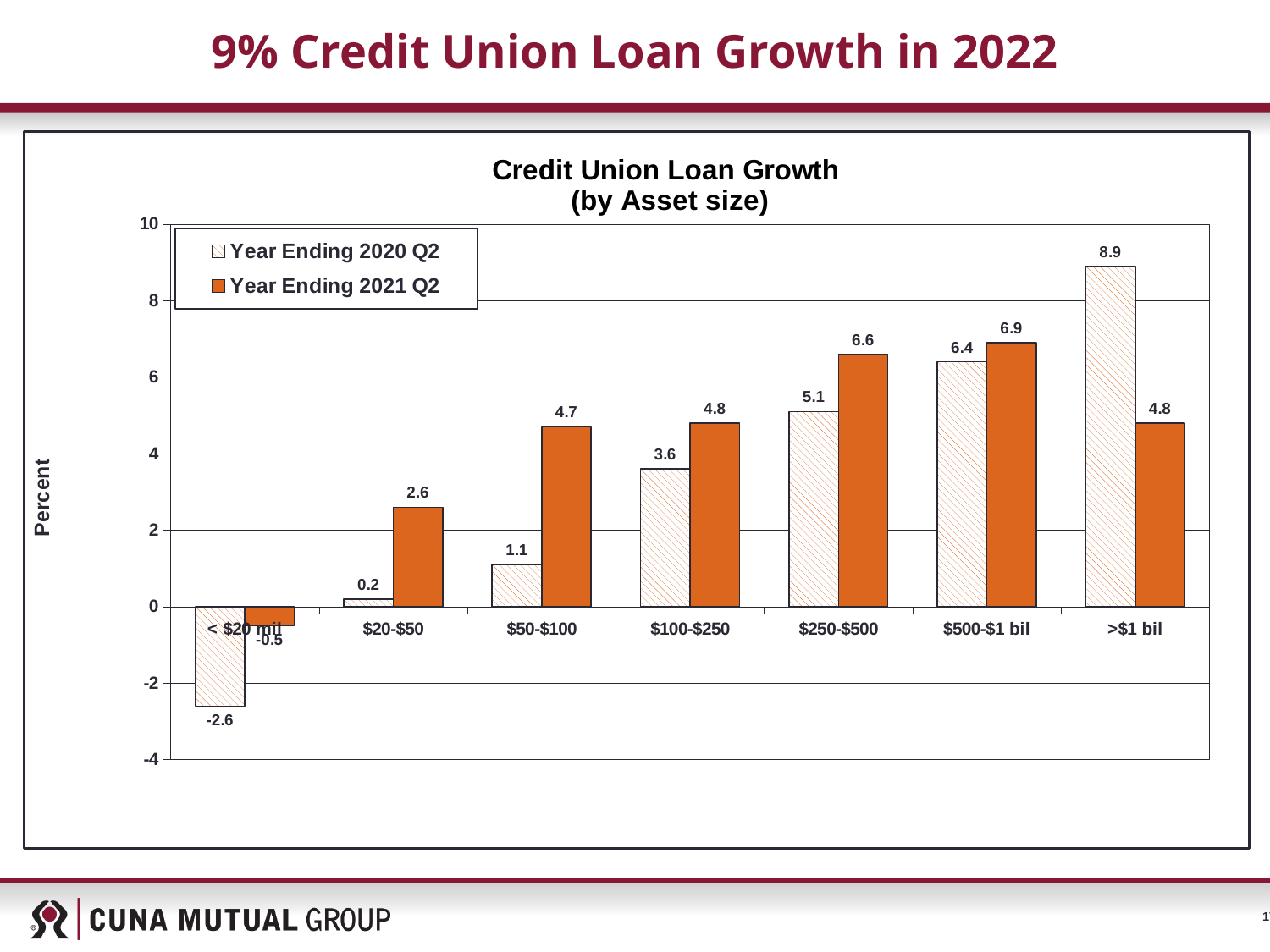
Which asset size group has the highest Year Ending 2021 Q2 loan growth? $500-$1 bil What is the difference between the Year Ending 2020 Q2 and Year Ending 2021 Q2 loan growth for the >$1 bil group? 4.1 For the $250-$500 group, which is larger: Year Ending 2020 Q2 or Year Ending 2021 Q2 loan growth? Year Ending 2021 Q2 What is the Year Ending 2021 Q2 loan growth for the $50-$100 asset size group? 4.7 What is the Year Ending 2020 Q2 loan growth for the >$1 bil asset size group? 8.9 Which asset size group has the lowest Year Ending 2020 Q2 loan growth? < $20 mil How many asset size groups are shown on the x axis? 7 What is the label on the vertical axis of the chart? Percent What is the Year Ending 2020 Q2 loan growth for the < $20 mil asset size group? -2.6 What kind of chart is shown on the slide? Bar chart How many series does the legend list? 2 Do the Year Ending 2020 Q2 values rise or fall as asset size increases from < $20 mil to >$1 bil? Rise